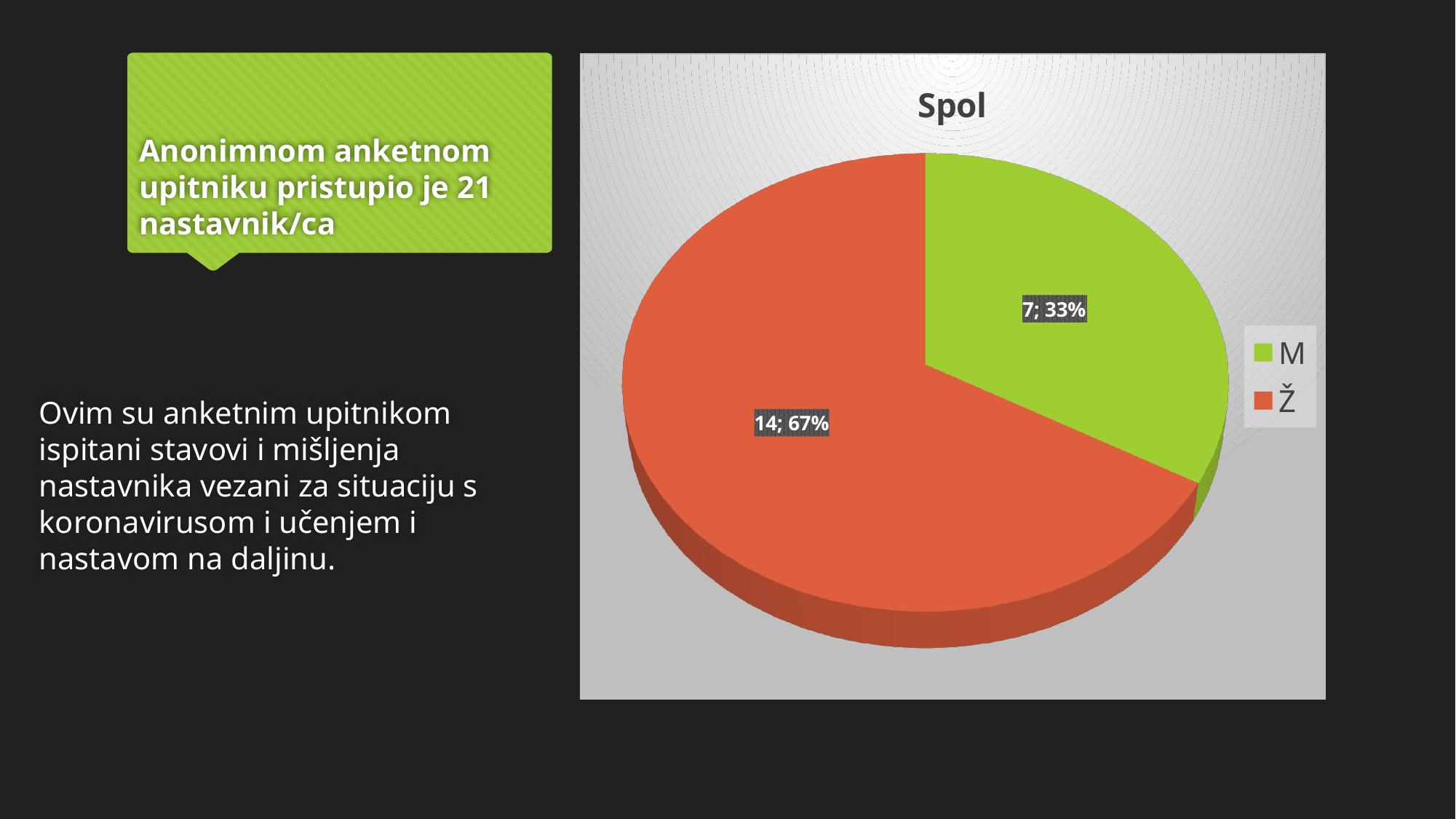
How many slices does the pie chart have? 2 Which colour represents Ž in the pie chart? orange What share of the pie does M represent? 33% Which category has the largest slice? Ž What is the title of the chart? Spol What kind of chart is shown on the slide? pie chart What share of the pie does Ž represent? 67% What is the difference between the counts for Ž and M? 7 What is the count for M in the pie chart? 7 Which category has the smallest slice? M How many entries does the legend list? 2 What is the count for Ž in the pie chart? 14